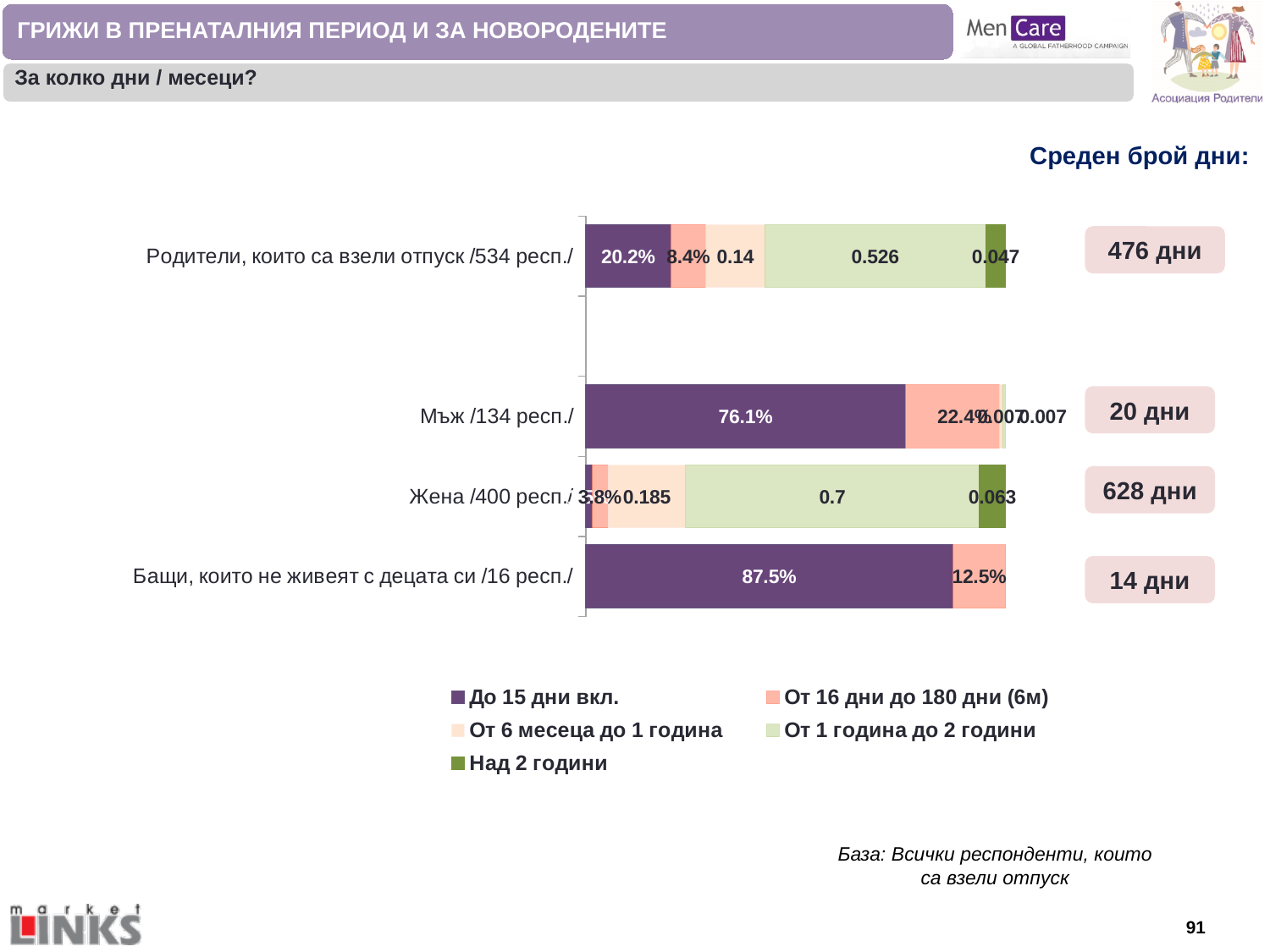
What is the value of 'От 16 дни до 180 дни (6м)' for 'Бащи, които не живеят с децата си /16 респ./'? 12.5% What type of chart is shown on the slide? stacked bar chart Which is larger: the 'До 15 дни вкл.' value for 'Мъж /134 респ./' or for 'Бащи, които не живеят с децата си /16 респ./'? Бащи, които не живеят с децата си /16 респ./ What is the value of 'До 15 дни вкл.' for 'Бащи, които не живеят с децата си /16 респ./'? 87.5% What is the value of 'От 1 година до 2 години' for 'Жена /400 респ./'? 0.7 How many series does the legend list? 5 Which category has the highest value for 'До 15 дни вкл.'? Бащи, които не живеят с децата си /16 респ./ What is the value of 'До 15 дни вкл.' for 'Родители, които са взели отпуск /534 респ./'? 20.2% How many categories are plotted on the chart? 4 What is the value of 'От 1 година до 2 години' for 'Родители, които са взели отпуск /534 респ./'? 0.526 What is the difference between the 'До 15 дни вкл.' values for 'Бащи, които не живеят с децата си /16 респ./' and 'Мъж /134 респ./'? 11.4% What is the value of 'До 15 дни вкл.' for 'Мъж /134 респ./'? 76.1%